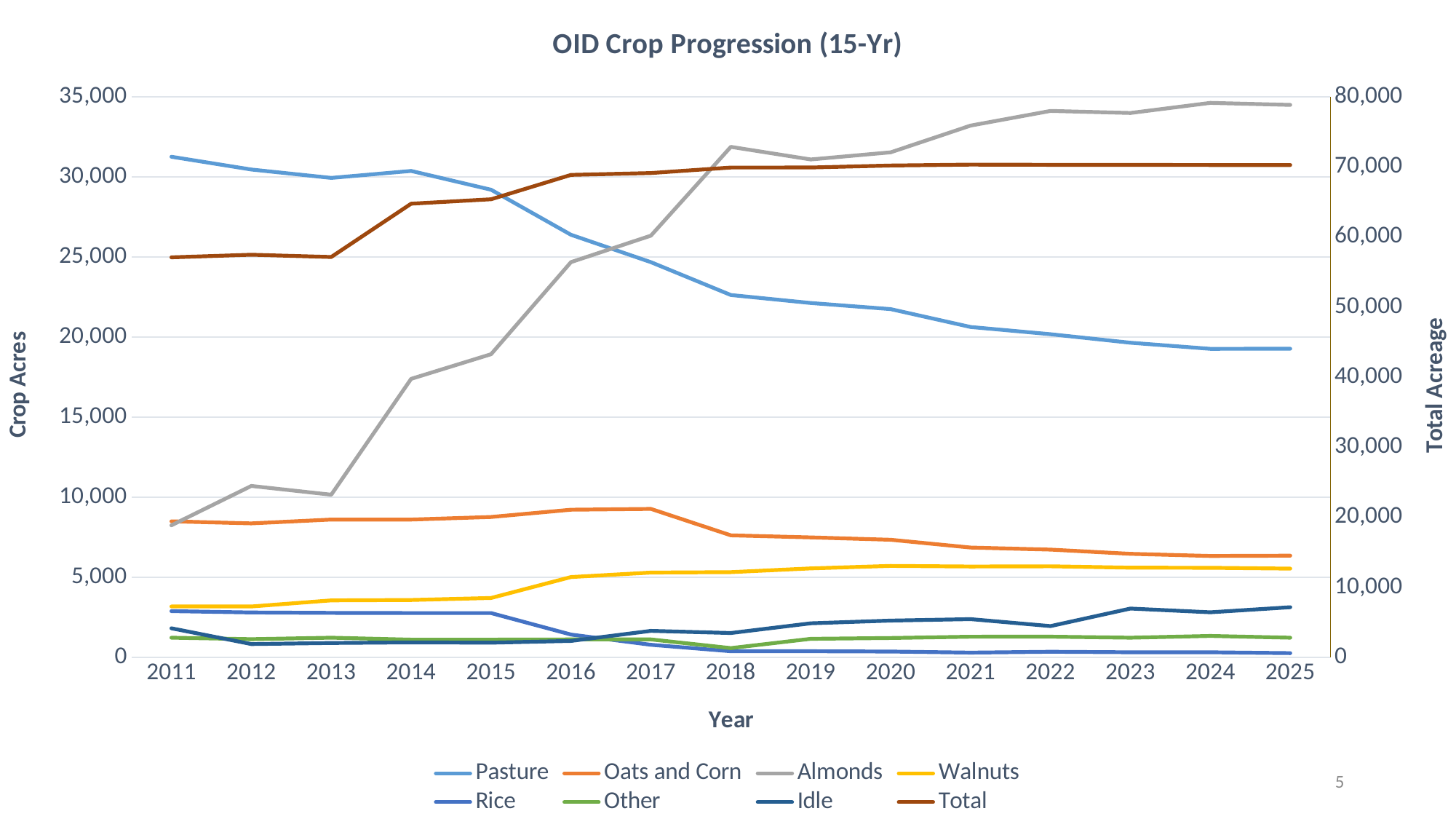
How many years are plotted along the x axis? 15 What kind of chart is shown on the slide? line chart Is the Total value in 2025, read on the right-hand Total Acreage axis, greater or less than 60,000? greater Which is larger in 2014, Pasture or Almonds? Pasture Is the value for Almonds in 2011 greater or less than 10,000? less What is the title of the chart? OID Crop Progression (15-Yr) Does the Almonds line rise or fall from 2011 to 2025? rise How many series does the legend list? 8 Is the value for Pasture in 2011 greater or less than 30,000? greater Does the Pasture line rise or fall from 2011 to 2025? fall Which of the crop series on the left axis has the lowest value in 2025? Rice